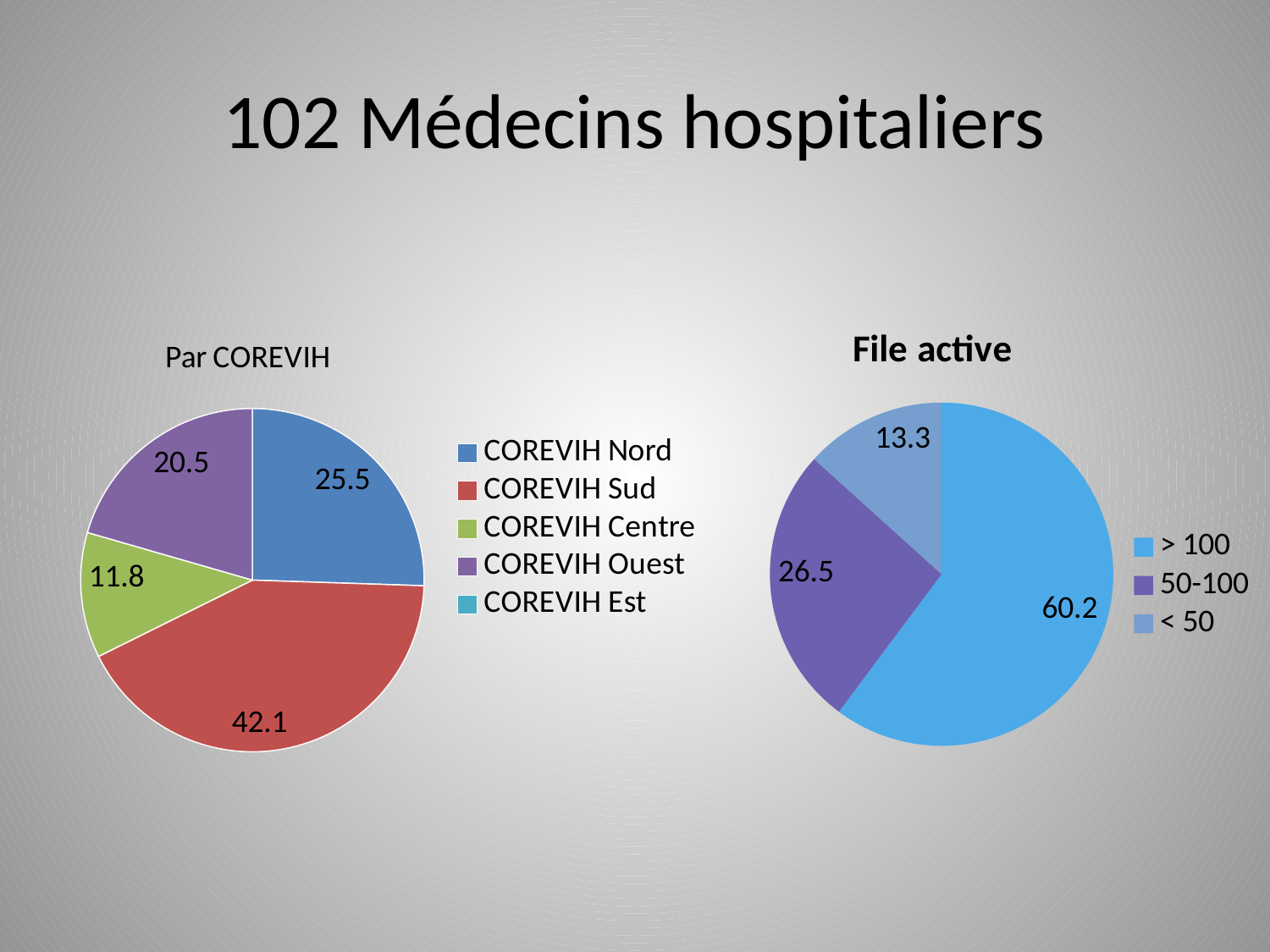
In the 'File active' chart, what is the difference between the '> 100' and '50-100' values? 33.7 In the 'Par COREVIH' pie chart, which labelled slice is the smallest? COREVIH Centre In the 'Par COREVIH' pie chart, what is the difference between the values for COREVIH Sud and COREVIH Nord? 16.6 In the 'Par COREVIH' pie chart, which COREVIH has the largest slice? COREVIH Sud In the 'File active' chart, what is the value shown for the '50-100' slice? 26.5 In the 'File active' chart, what is the value shown for the '> 100' slice? 60.2 In the 'Par COREVIH' pie chart, what is the value shown for COREVIH Centre? 11.8 What kind of chart is the 'File active' chart? Pie chart In the 'Par COREVIH' pie chart, which is larger, COREVIH Nord or COREVIH Ouest? COREVIH Nord In the 'File active' chart, which category has the smallest slice? < 50 In the 'Par COREVIH' pie chart, how many entries does the legend list? 5 In the 'Par COREVIH' pie chart, what is the value shown for COREVIH Sud? 42.1